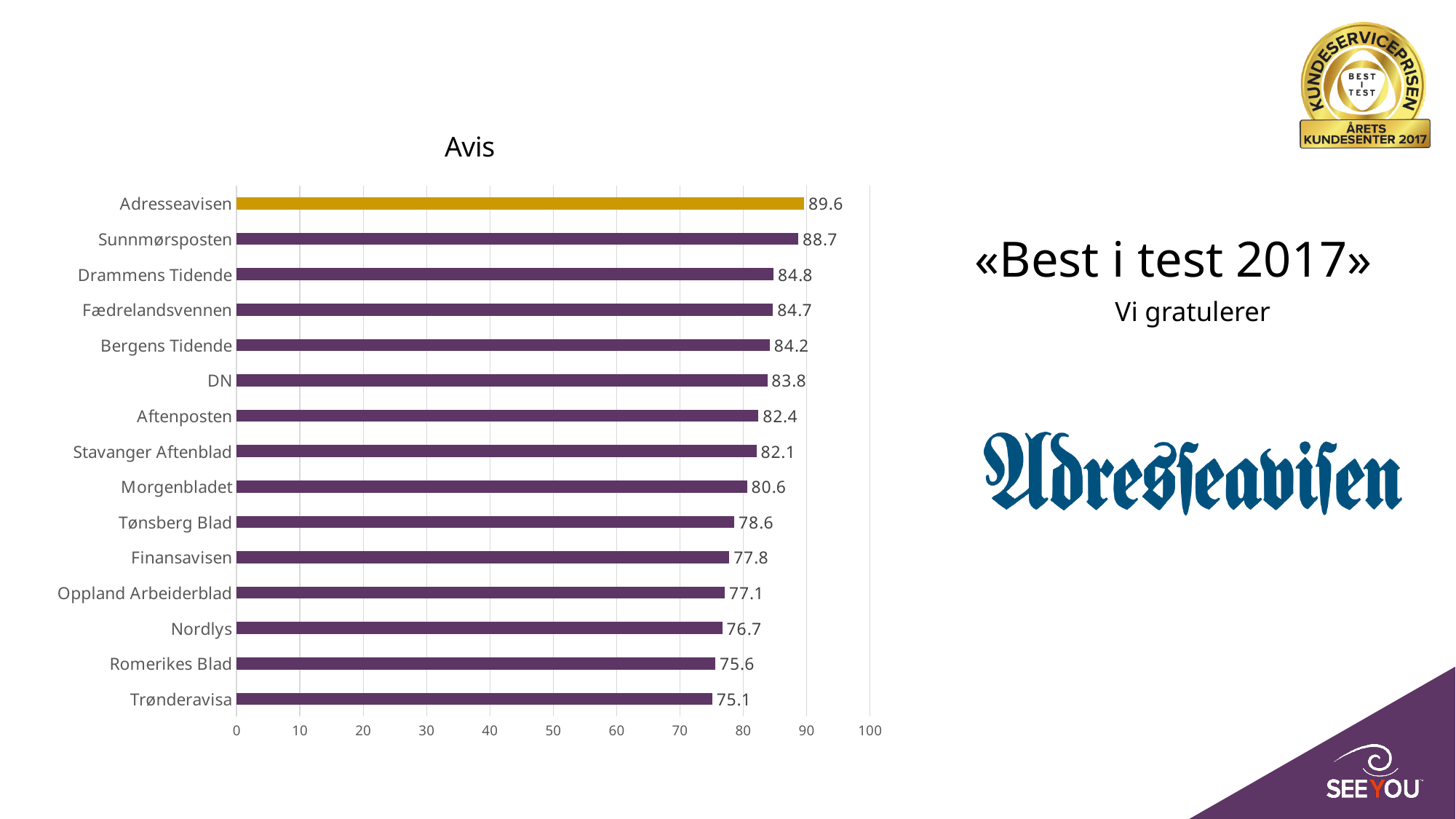
What is the value for Morgenbladet? 80.6 Which newspaper has the lowest value? Trønderavisa Which has a larger value, Drammens Tidende or Tønsberg Blad? Drammens Tidende What kind of chart is shown on the slide? bar chart Which newspaper has the highest value? Adresseavisen What is the value for Nordlys? 76.7 What is the value for Adresseavisen? 89.6 What is the title of the chart? Avis What is the difference between the values for Adresseavisen and Sunnmørsposten? 0.9 Is the value for Finansavisen greater or less than 80? less What is the difference between the values for Aftenposten and Trønderavisa? 7.3 How many newspapers are shown in the chart? 15